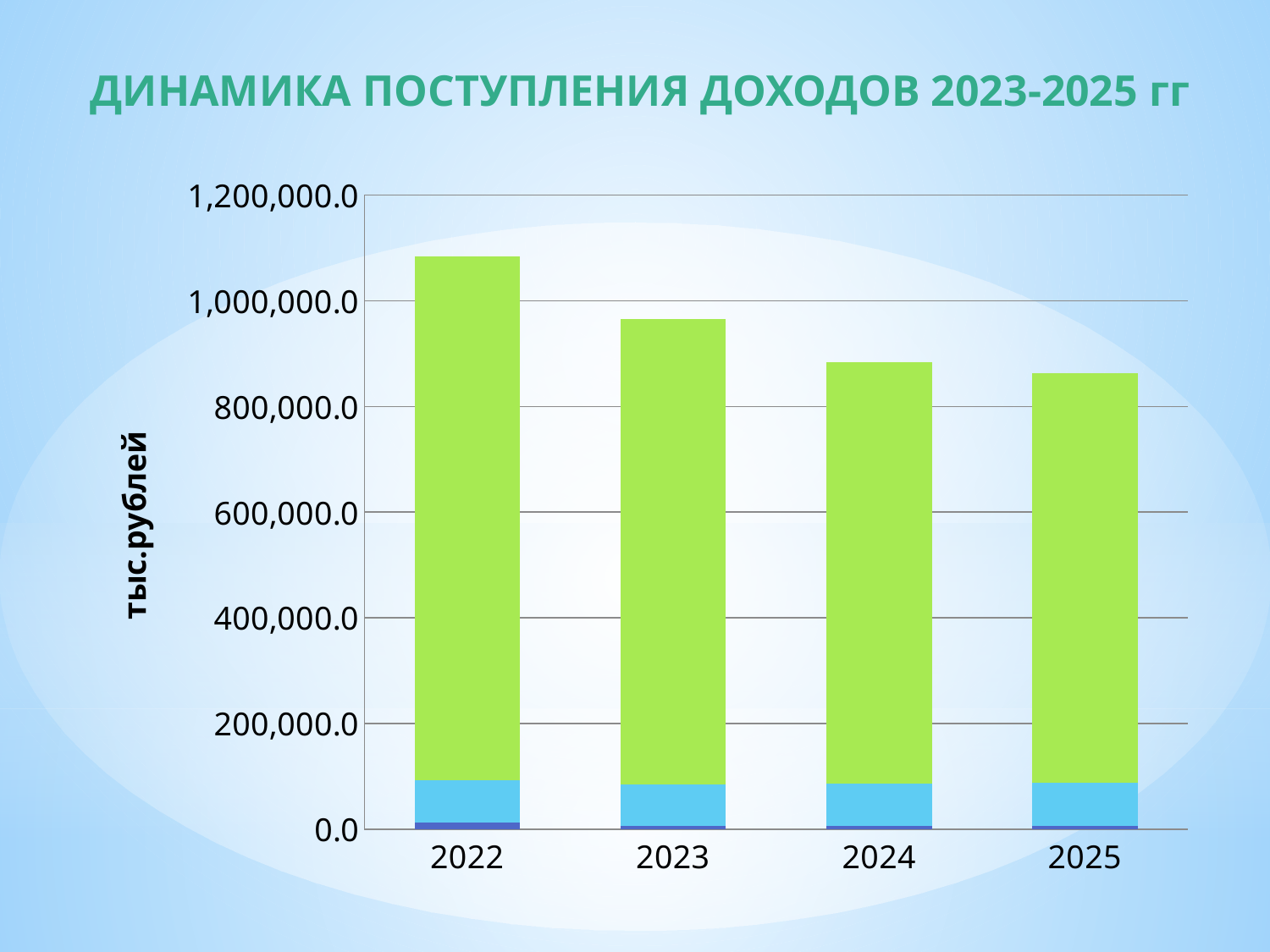
Do the bar heights rise or fall from 2022 to 2025? fall Is the total bar height for 2022 greater or less than 1,000,000.0? greater Is the total bar height for 2025 greater or less than 1,000,000.0? less Is the total bar height for 2024 greater or less than 800,000.0? greater What is the title of the chart on the slide? ДИНАМИКА ПОСТУПЛЕНИЯ ДОХОДОВ 2023-2025 гг What is the label on the vertical axis of the chart? тыс.рублей What kind of chart is shown on the slide? bar chart How many years (categories) are shown on the x axis of the chart? 4 Which year has the tallest bar in the chart? 2022 Which bar is taller, 2023 or 2024? 2023